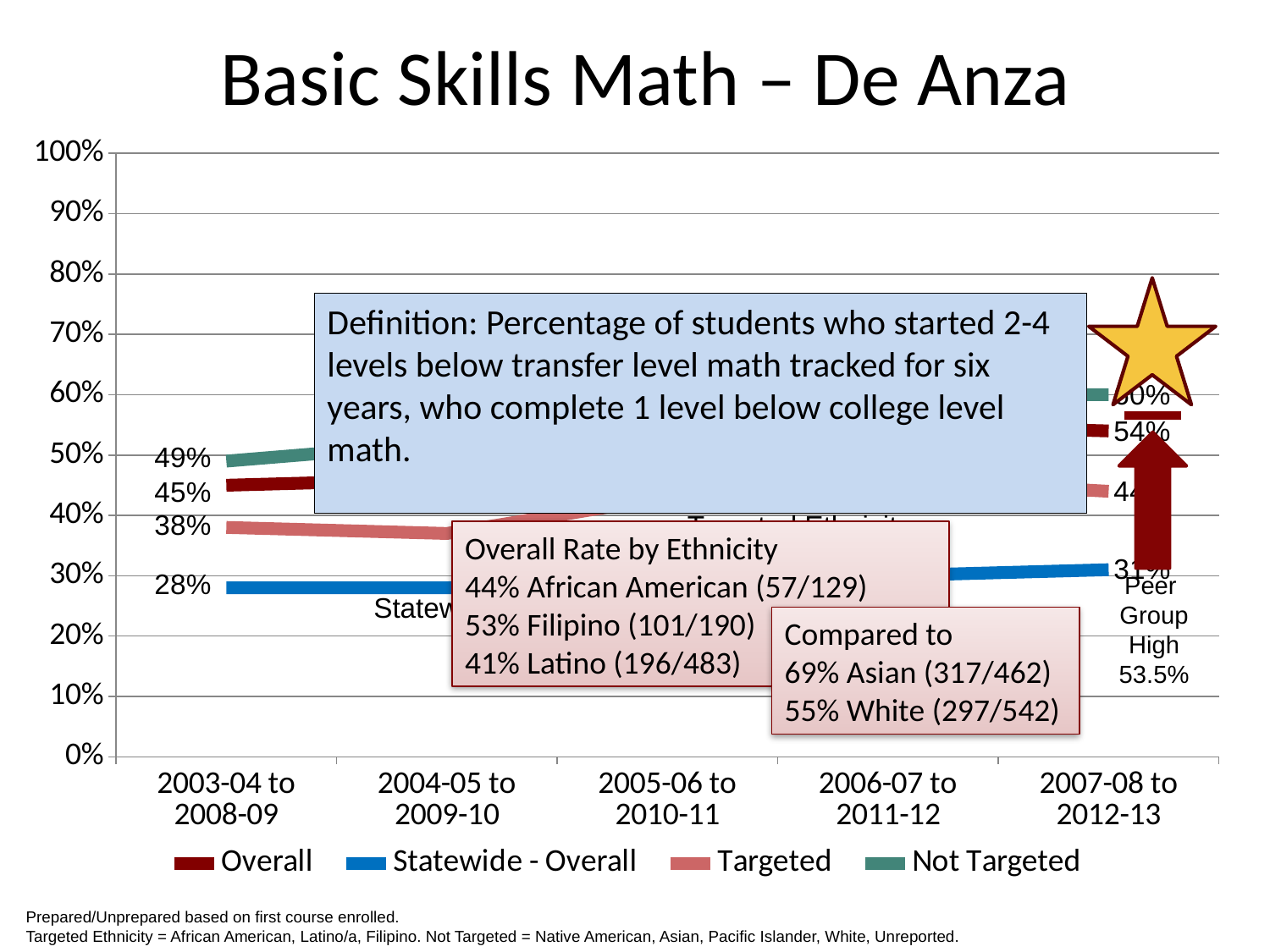
What is the Not Targeted value for 2003-04 to 2008-09? 49% Which series has the highest value in 2003-04 to 2008-09? Not Targeted What is the Overall value for 2003-04 to 2008-09? 45% How many time periods are shown along the x axis? 5 What is the Targeted value for 2003-04 to 2008-09? 38% By how many percentage points did the Overall value change from 2003-04 to 2008-09 to 2007-08 to 2012-13? 9 percentage points How many series does the chart legend list? 4 Does the Overall series rise or fall from the first period to the last period? Rise What is the Statewide - Overall value for 2003-04 to 2008-09? 28% What kind of chart is shown on the slide? Line chart What is the Overall value for 2007-08 to 2012-13? 54% Which series has the lowest value in 2003-04 to 2008-09? Statewide - Overall